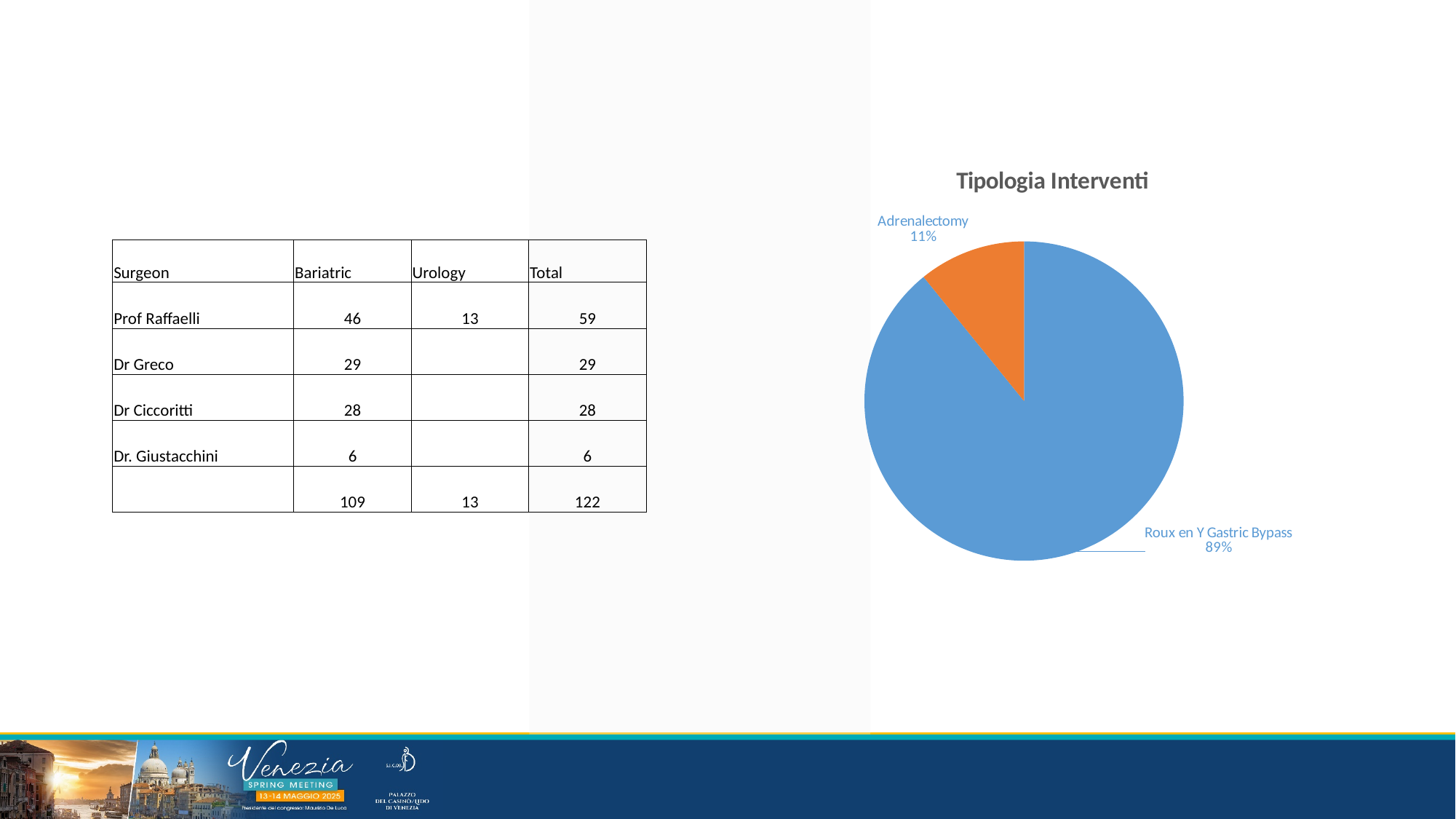
What colour is the Adrenalectomy slice in the pie chart? orange What share of the pie does Roux en Y Gastric Bypass represent? 89% What is the title of the pie chart? Tipologia Interventi Which slice of the pie chart is the smallest? Adrenalectomy What is the difference in percentage points between the Roux en Y Gastric Bypass share and the Adrenalectomy share? 78 Which is larger in the pie chart, Adrenalectomy or Roux en Y Gastric Bypass? Roux en Y Gastric Bypass What share of the pie does Adrenalectomy represent? 11% How many slices does the pie chart have? 2 What kind of chart is shown on the slide? pie chart Which slice of the pie chart is the largest? Roux en Y Gastric Bypass